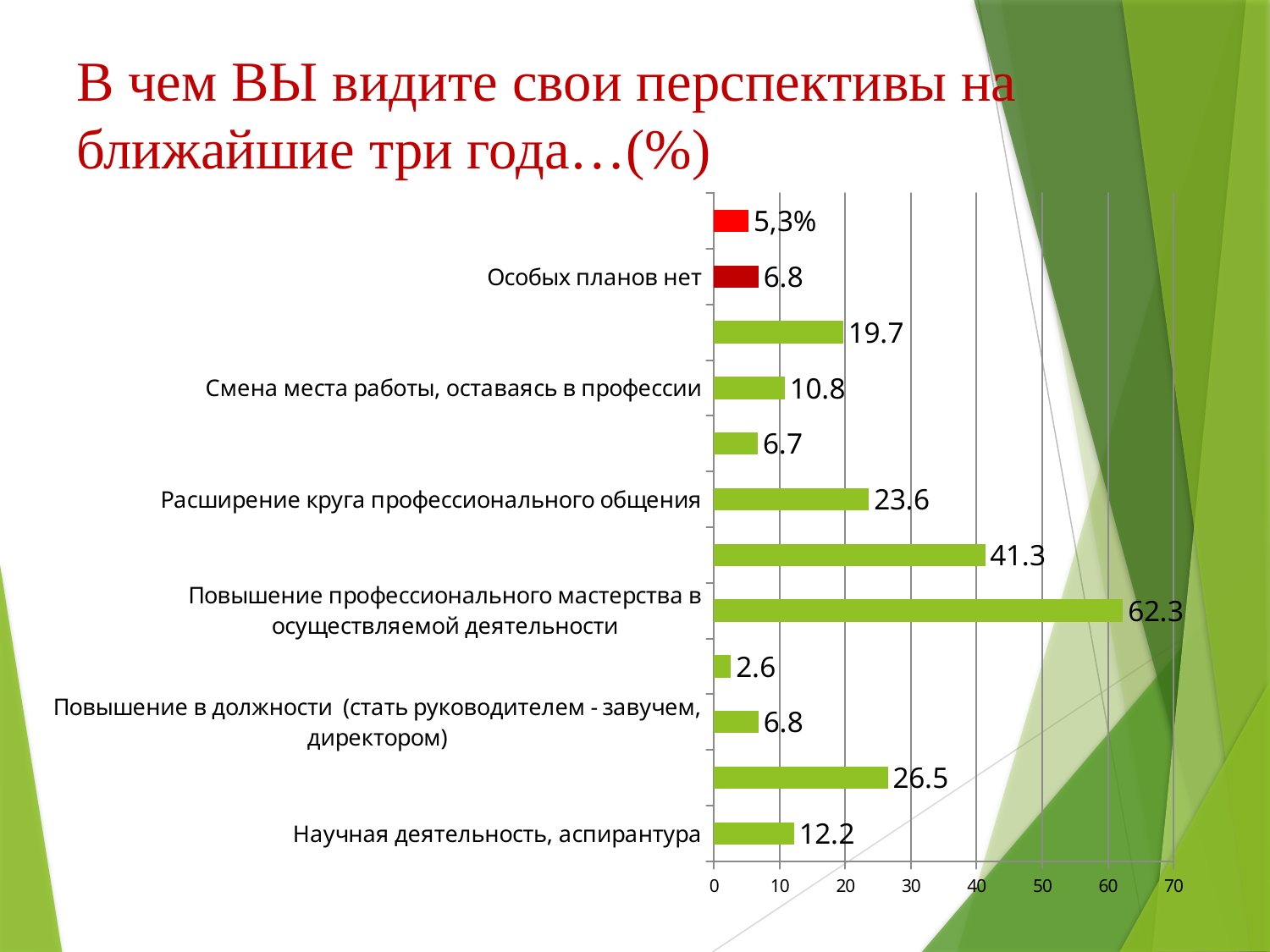
What is the value of the lower bar for "Научная деятельность, аспирантура"? 12.2 What is the value of the lower bar for "Повышение профессионального мастерства в осуществляемой деятельности"? 62.3 How many categories are listed on the vertical axis of the chart? 6 What kind of chart is shown on the slide? bar chart What is the value of the shortest bar in the chart? 2.6 Is the value of the longest bar for "Повышение профессионального мастерства в осуществляемой деятельности" greater or less than 60? greater What is the highest tick value shown on the horizontal axis? 70 Which is larger: the lower bar for "Расширение круга профессионального общения" or the lower bar for "Смена места работы, оставаясь в профессии"? Расширение круга профессионального общения Which category has the longest bar in the chart? Повышение профессионального мастерства в осуществляемой деятельности